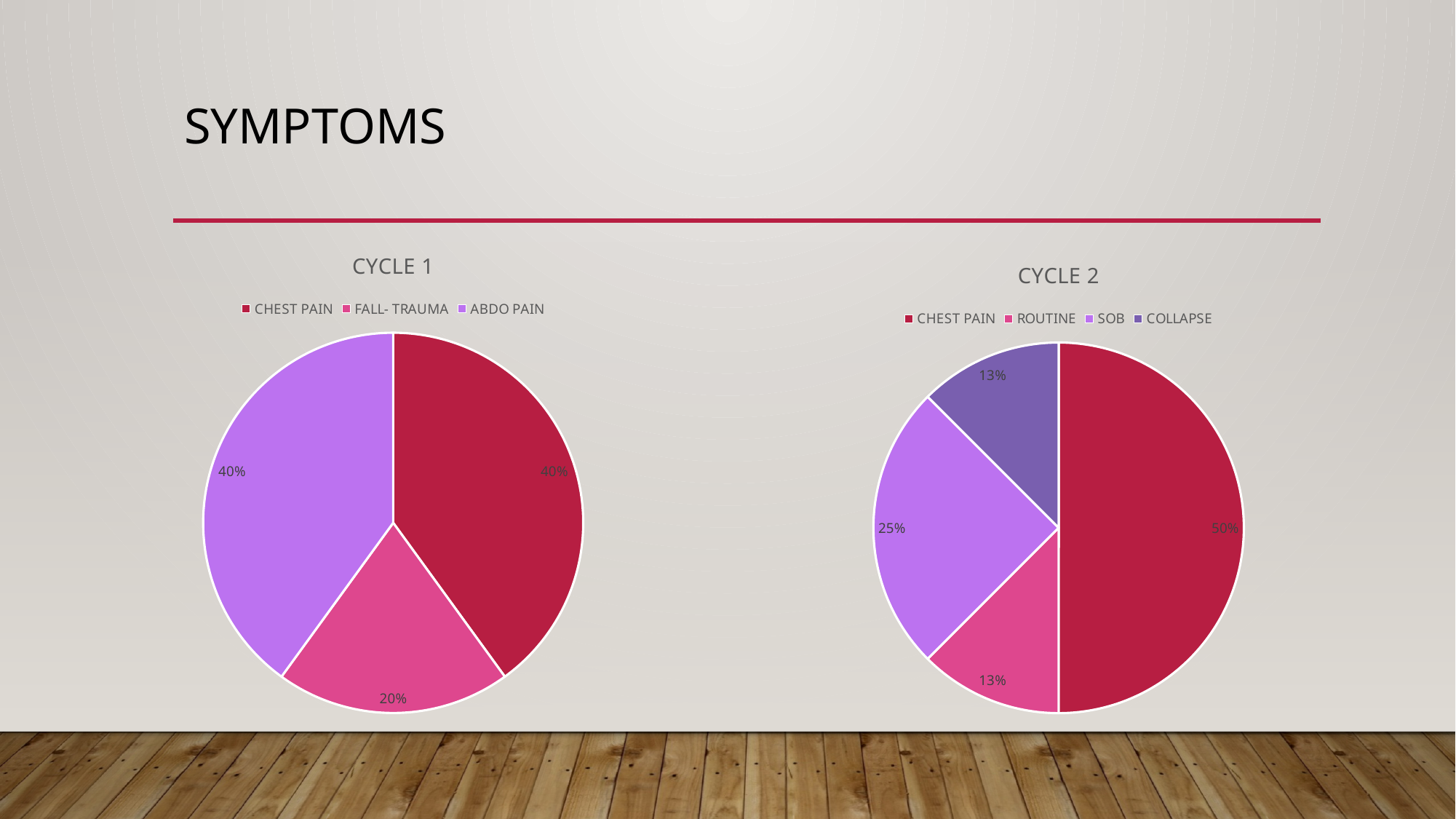
In the Cycle 1 chart, how many categories does the legend list? 3 In the Cycle 2 chart, what share of the pie is SOB? 25% In the Cycle 2 chart, how many categories does the legend list? 4 In the Cycle 2 chart, which is larger, the SOB slice or the Collapse slice? SOB In the Cycle 1 chart, what share of the pie is Fall- Trauma? 20% What is the title of the chart on the left of the slide? Cycle 1 In the Cycle 2 chart, which category has the largest slice? Chest Pain In the Cycle 1 chart, what share of the pie is Chest Pain? 40% In the Cycle 1 chart, which category has the smallest slice? Fall- Trauma In the Cycle 2 chart, what is the difference between the Chest Pain share and the SOB share? 25% What kind of chart is the Cycle 1 chart? Pie chart